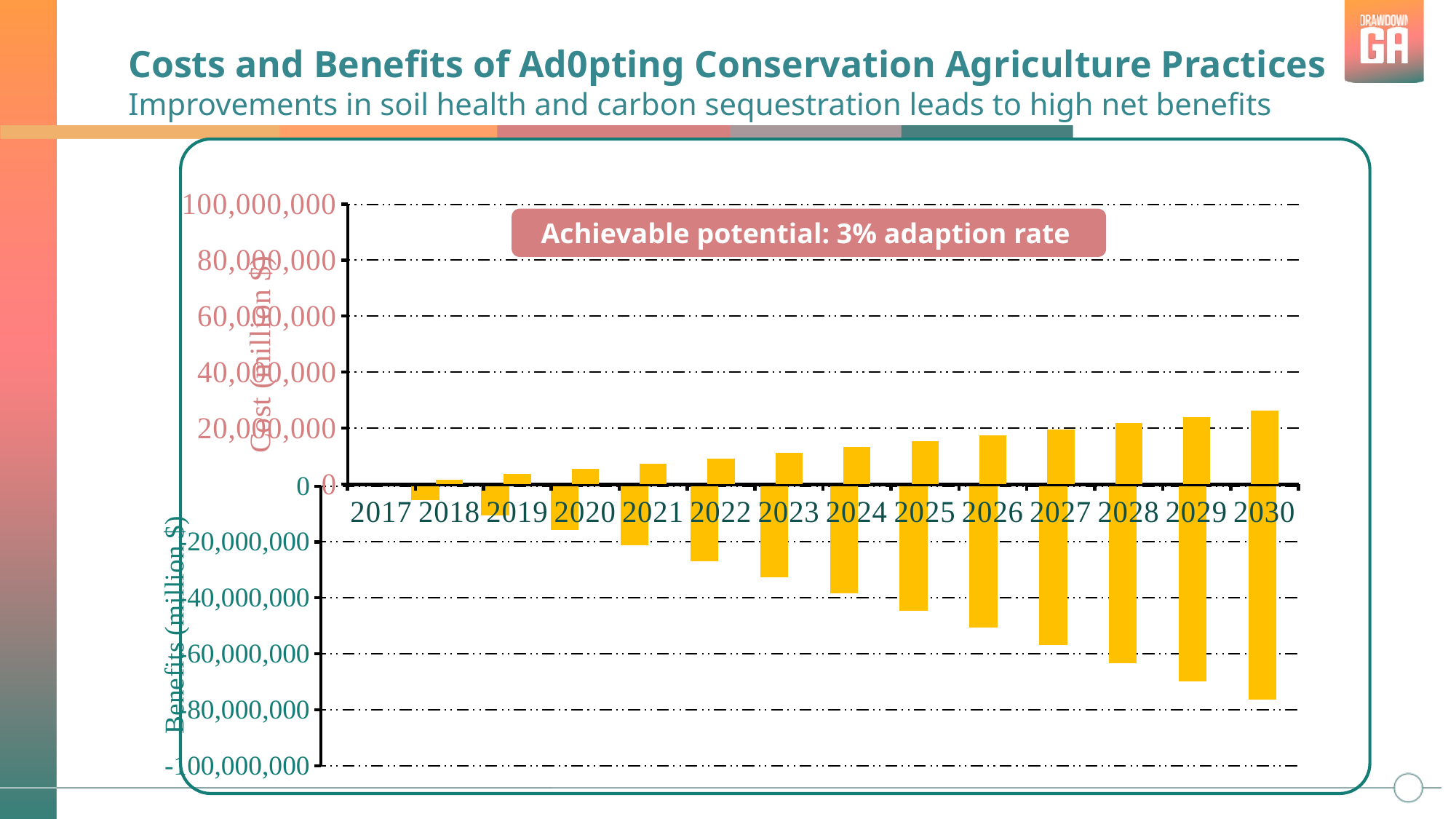
What colour are the bars in the chart? yellow What kind of chart is shown on the slide? bar chart Which year has the tallest positive (cost) bar? 2030 What adaption rate is stated in the annotation box on the chart? 3% Is the negative benefits bar for 2026 greater or less than -40,000,000? less Is the positive cost bar for 2030 greater or less than 20,000,000? greater Is the negative benefits bar for 2030 greater or less than -60,000,000? less Do the positive cost bars rise or fall from 2018 to 2030? rise Which year has the lowest (most negative) benefits bar? 2030 Which year has a larger positive cost bar, 2020 or 2027? 2027 How many years are shown along the x axis of the chart? 14